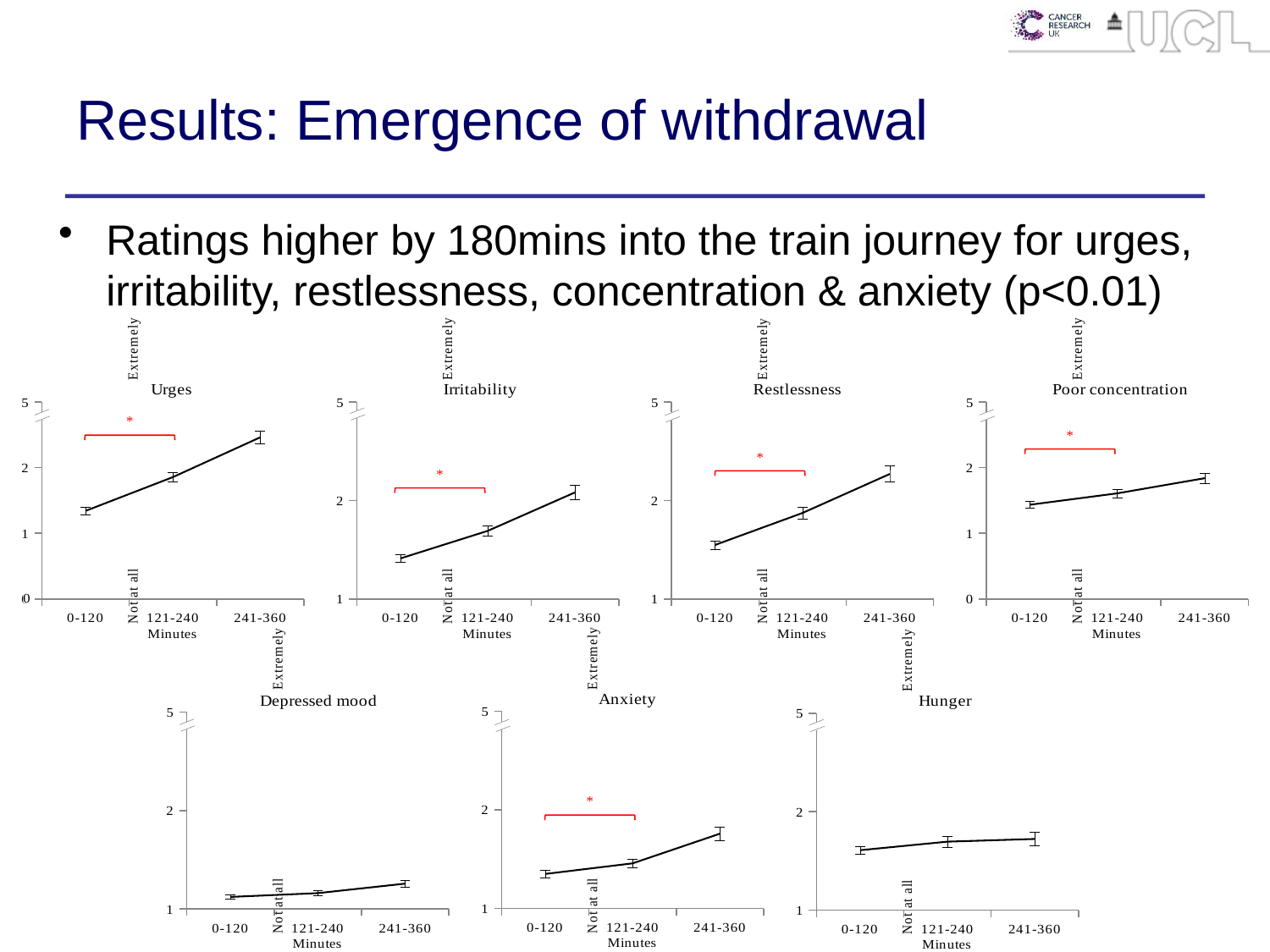
What kind of chart is the Urges chart? Line chart How many time-interval categories are on the x axis of the Irritability chart? 3 In the Urges chart, do the ratings rise or fall from 0-120 to 241-360 minutes? Rise How many charts are shown on the slide? 7 In the Poor concentration chart, is the value for 241-360 minutes greater or less than 2? less In the Restlessness chart, do the ratings rise or fall across the three time intervals? Rise In the Urges chart, is the value for 0-120 minutes greater or less than 2? less In the Urges chart, is the value for 241-360 minutes greater or less than 2? greater What is the x-axis label on the Hunger chart? Minutes In the Depressed mood chart, which time interval has the highest rating? 241-360 In the Irritability chart, which time interval has the lowest rating? 0-120